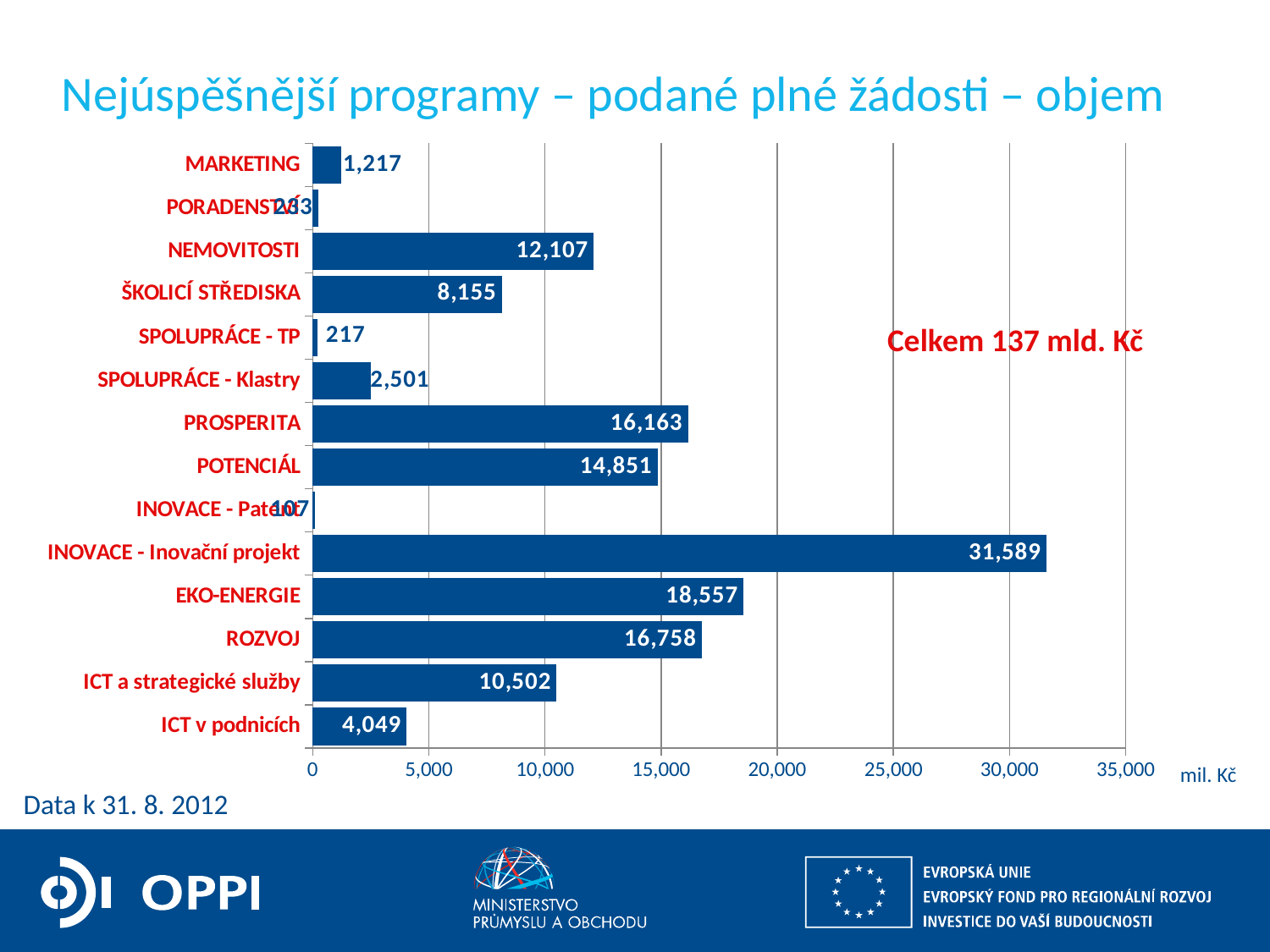
What total amount is stated in the annotation on the chart? Celkem 137 mld. Kč What is the value for SPOLUPRÁCE - TP? 217 Which is larger, the value for NEMOVITOSTI or the value for ICT a strategické služby? NEMOVITOSTI What is the value for EKO-ENERGIE? 18,557 How many programs are shown in the chart? 14 What kind of chart is shown on the slide? bar chart What is the difference between the values for PROSPERITA and POTENCIÁL? 1,312 Is the value for ICT v podnicích greater or less than 5,000? less Which program has the highest value? INOVACE - Inovační projekt What is the value for INOVACE - Inovační projekt? 31,589 What is the difference between the values for EKO-ENERGIE and ROZVOJ? 1,799 What is the value for ŠKOLICÍ STŘEDISKA? 8,155